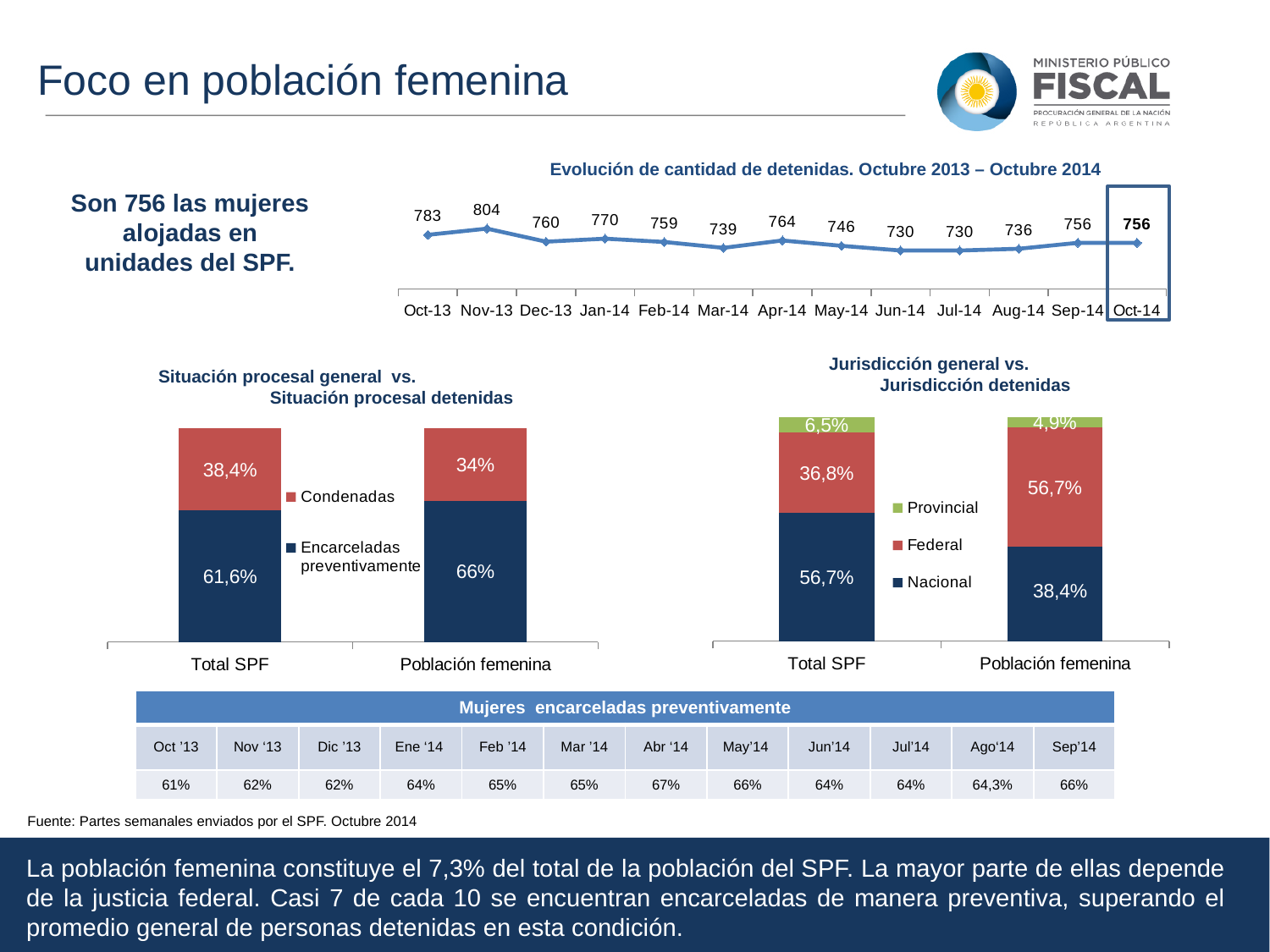
In the chart 'Situación procesal general vs. Situación procesal detenidas', what is the Condenadas share for Población femenina? 34% In the chart 'Jurisdicción general vs. Jurisdicción detenidas', what is the difference between the Provincial value for Total SPF and the Provincial value for Población femenina? 1,6% What type of chart is 'Evolución de cantidad de detenidas. Octubre 2013 – Octubre 2014'? Line chart In the chart 'Situación procesal general vs. Situación procesal detenidas', how many series does the legend list? 2 In the line chart 'Evolución de cantidad de detenidas', what is the difference between the Oct-13 value and the Oct-14 value? 27 In the line chart 'Evolución de cantidad de detenidas', which is larger, the value for Apr-14 or the value for May-14? Apr-14 In the chart 'Jurisdicción general vs. Jurisdicción detenidas', how many series does the legend list? 3 In the line chart 'Evolución de cantidad de detenidas', what is the value for Nov-13? 804 In the line chart 'Evolución de cantidad de detenidas', how many data points are plotted? 13 In the line chart 'Evolución de cantidad de detenidas', which month has the highest value? Nov-13 In the chart 'Situación procesal general vs. Situación procesal detenidas', what is the Encarceladas preventivamente value for Total SPF? 61,6% In the chart 'Jurisdicción general vs. Jurisdicción detenidas', what is the Federal value for Población femenina? 56,7%